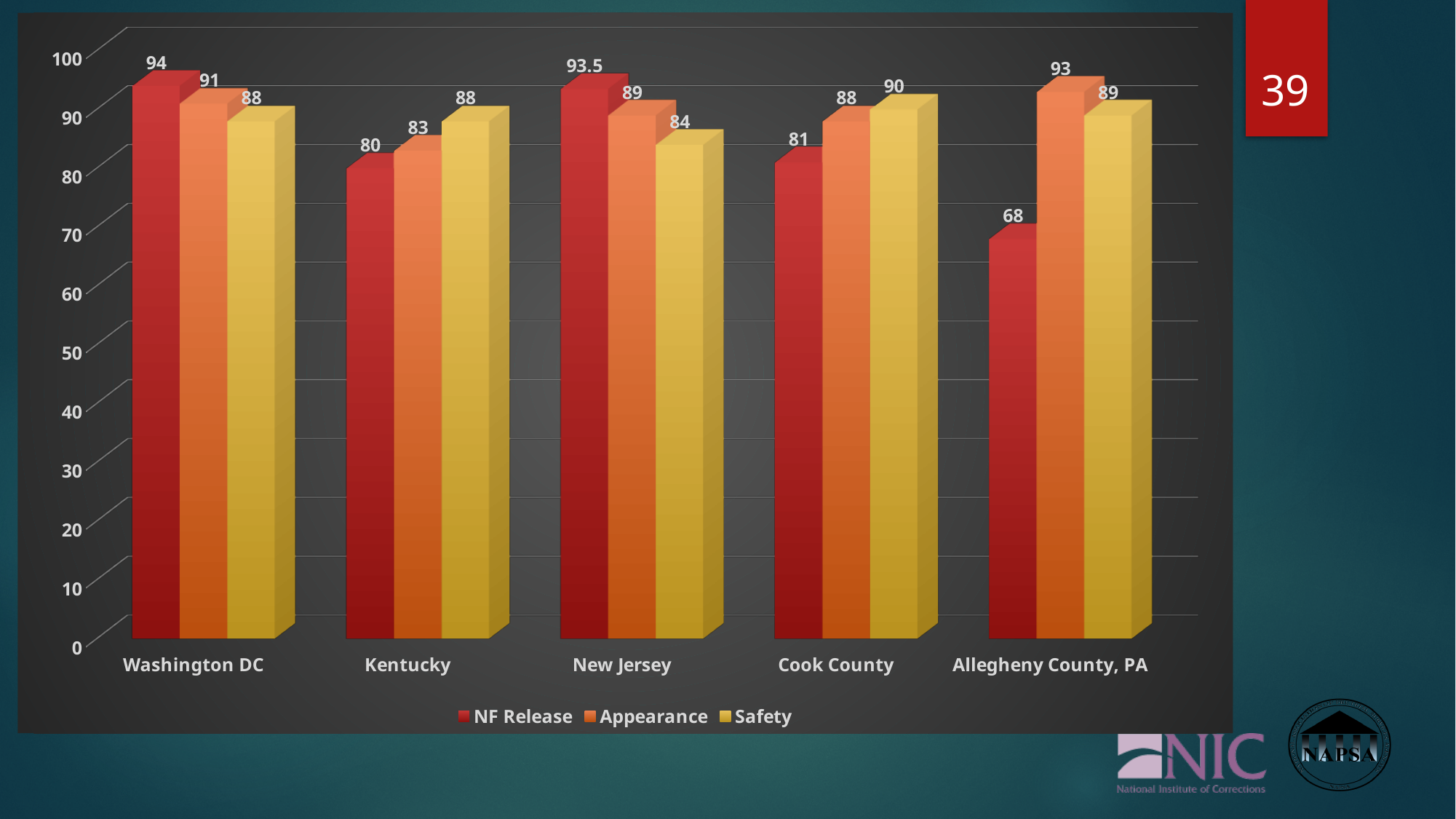
What is the NF Release value for New Jersey? 93.5 What is the Appearance value for Allegheny County, PA? 93 What is the difference between the NF Release value for Washington DC and the NF Release value for Allegheny County, PA? 26 Which is larger for Kentucky: the NF Release value or the Safety value? Safety How many categories are shown on the x axis? 5 What is the Safety value for Cook County? 90 Which category has the lowest NF Release value? Allegheny County, PA Which category has the highest Appearance value? Allegheny County, PA What kind of chart is shown on the slide? Bar chart What is the NF Release value for Washington DC? 94 How many series does the legend list? 3 Which series is shown in red in the legend? NF Release